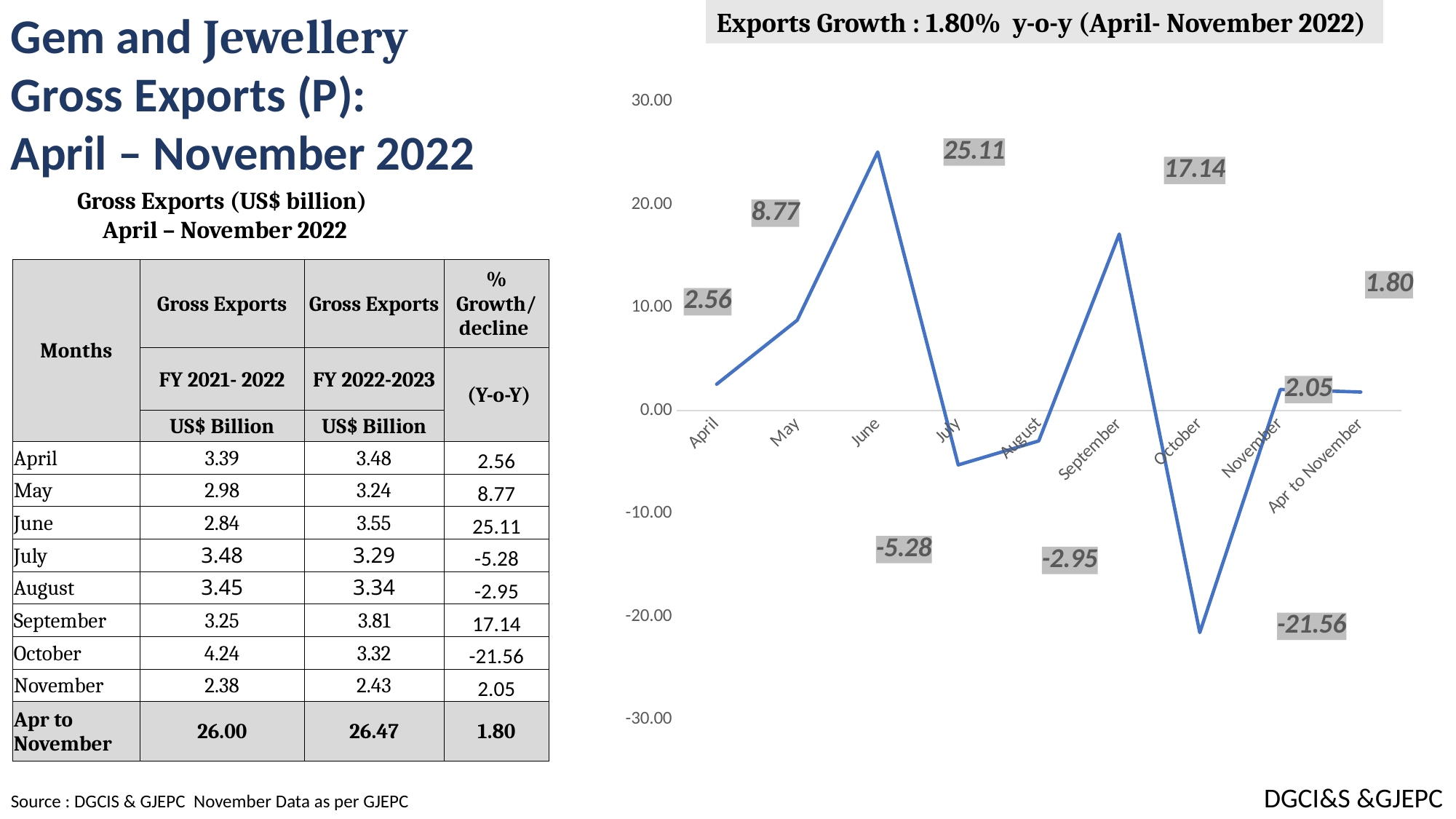
Does the line rise or fall from September to October? fall Which is larger on the line chart, the value for April or the value for November? April What is the value plotted for June on the line chart? 25.11 What is the title shown above the line chart? Exports Growth : 1.80% y-o-y (April- November 2022) How many categories are plotted along the x axis of the line chart? 9 Which category on the line chart has the lowest value? October Is the value for September on the line chart greater or less than 10.00? greater Which category on the line chart has the highest value? June What is the difference between the values for June and May on the line chart? 16.34 What kind of chart is shown on the slide? line chart What is the value plotted for September on the line chart? 17.14 What is the value plotted for October on the line chart? -21.56